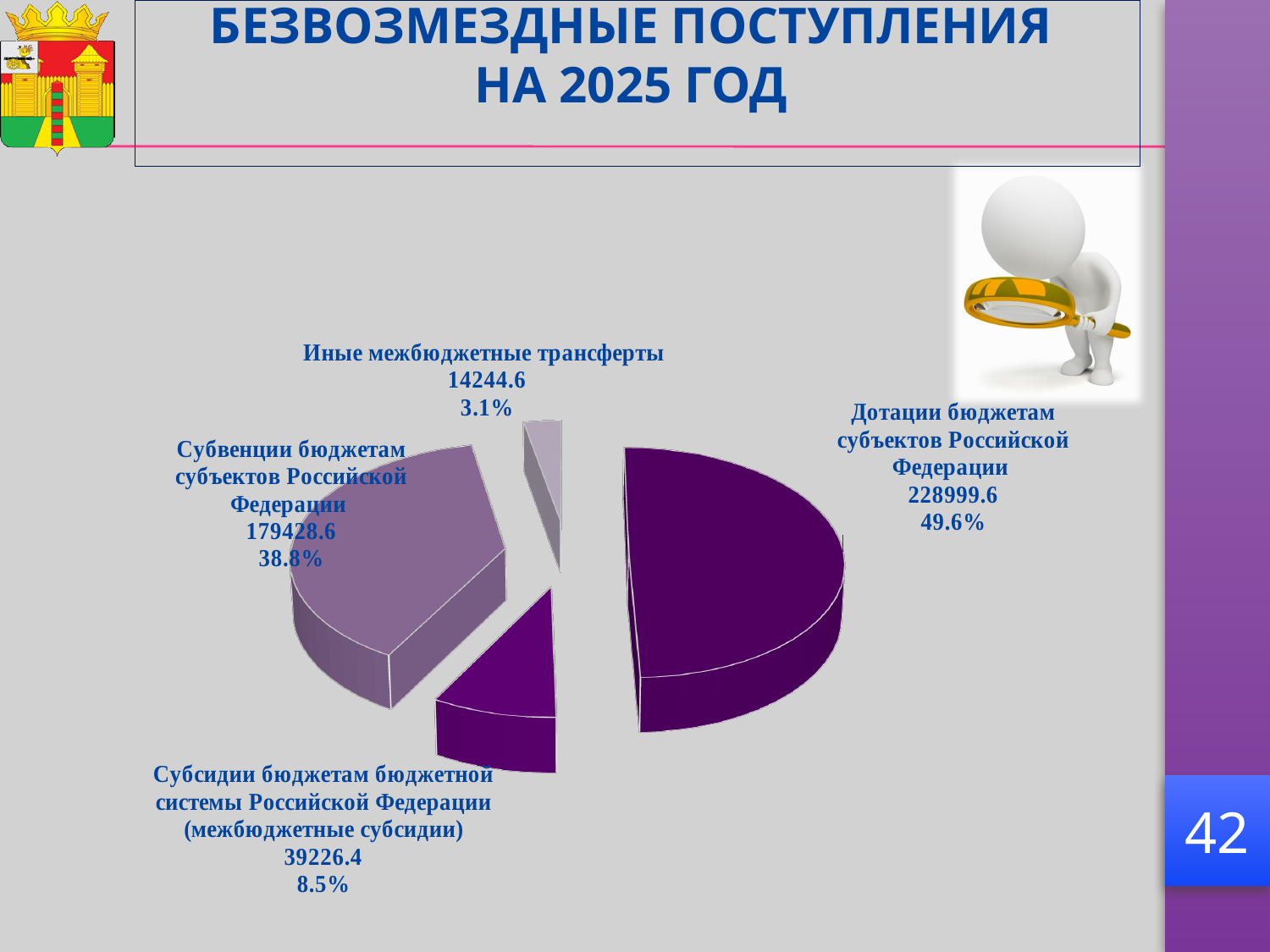
What type of chart is shown on the slide? Pie chart What share of the pie does "Субвенции бюджетам субъектов Российской Федерации" represent? 38.8% What percentage is shown for "Субсидии бюджетам бюджетной системы Российской Федерации (межбюджетные субсидии)"? 8.5% What is the total of all four values shown on the pie chart? 461899.2 What is the title of the slide containing the chart? БЕЗВОЗМЕЗДНЫЕ ПОСТУПЛЕНИЯ НА 2025 ГОД Which category has the largest slice of the pie? Дотации бюджетам субъектов Российской Федерации Which is larger: the value for "Субсидии бюджетам бюджетной системы Российской Федерации (межбюджетные субсидии)" or for "Иные межбюджетные трансферты"? Субсидии бюджетам бюджетной системы Российской Федерации (межбюджетные субсидии) What is the difference between the values for "Дотации бюджетам субъектов Российской Федерации" and "Субвенции бюджетам субъектов Российской Федерации"? 49571.0 What is the value for "Дотации бюджетам субъектов Российской Федерации"? 228999.6 Which category has the smallest slice of the pie? Иные межбюджетные трансферты What is the value for "Иные межбюджетные трансферты"? 14244.6 How many categories (slices) does the pie chart have? 4